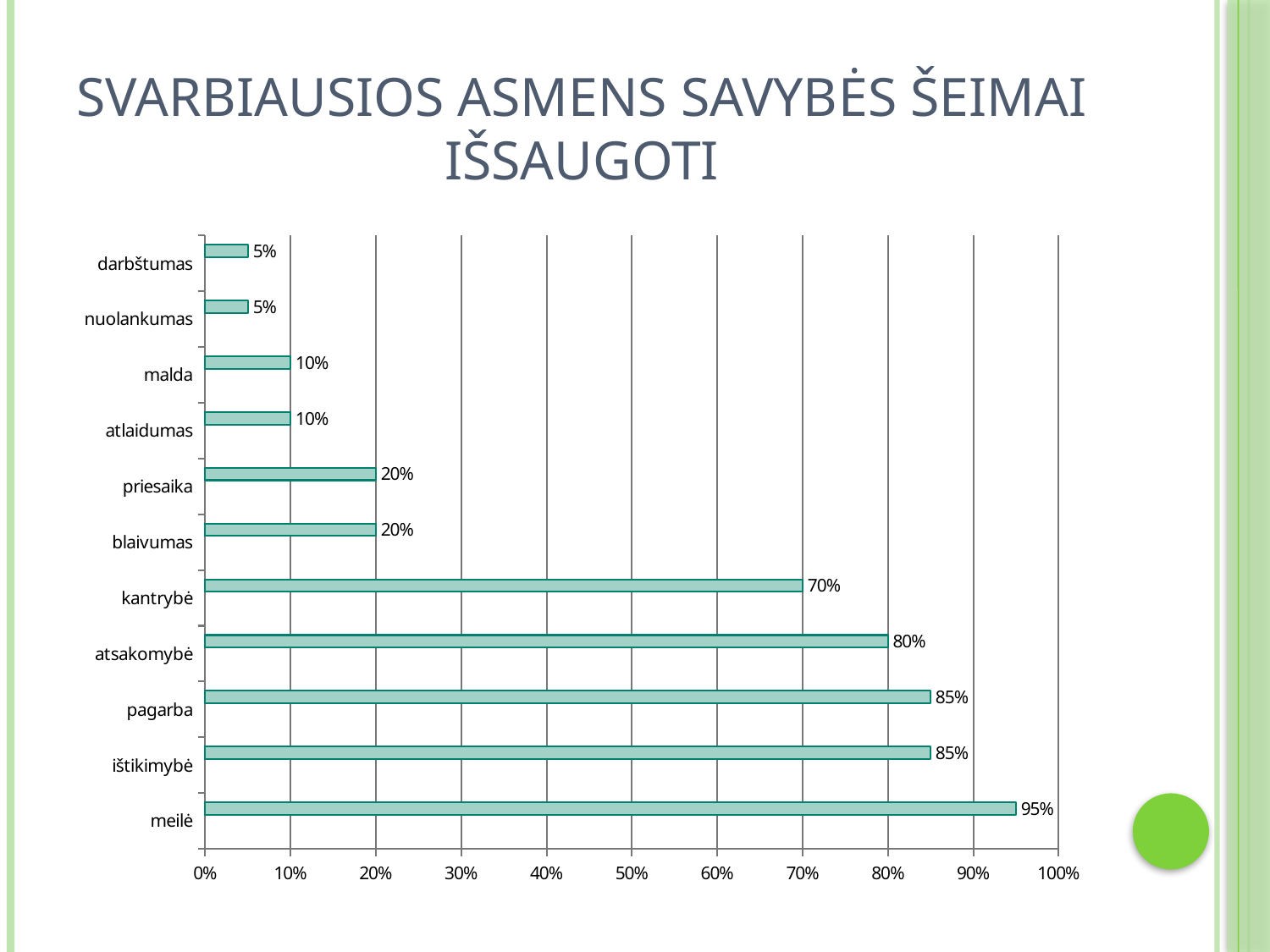
Which category has the highest value? meilė Which is larger, the value for pagarba or the value for atsakomybė? pagarba What is the value for kantrybė? 70% What kind of chart is shown on the slide? bar chart What is the title of the slide? SVARBIAUSIOS ASMENS SAVYBĖS ŠEIMAI IŠSAUGOTI What is the value for meilė? 95% What is the difference between the values for atsakomybė and blaivumas? 60% Which is larger, the value for malda or the value for priesaika? priesaika What is the value for atsakomybė? 80% What is the value for priesaika? 20% What is the difference between the values for meilė and kantrybė? 25% How many categories are shown in the chart? 11